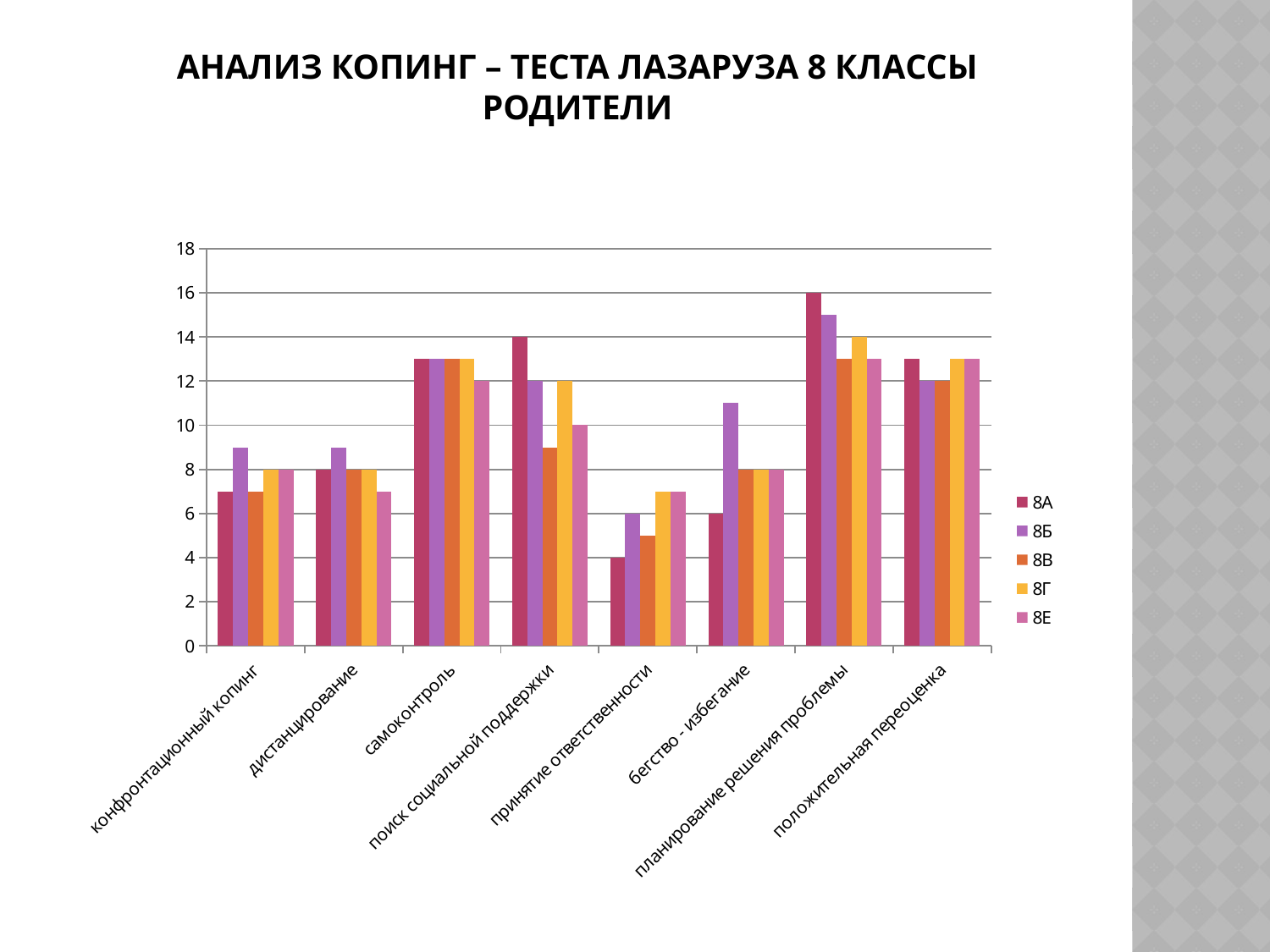
What is the value for 8А in the category 'поиск социальной поддержки'? 14 What is the value for 8А in the category 'принятие ответственности'? 4 In the category 'поиск социальной поддержки', which is larger: the value for 8А or the value for 8В? 8А Is the value for 8Б in 'бегство - избегание' greater or less than 10? greater What is the difference between the 8А value for 'планирование решения проблемы' and the 8А value for 'принятие ответственности'? 12 What kind of chart is shown on the slide? bar chart Which category has the highest value for 8А? планирование решения проблемы What is the value for 8Е in the category 'поиск социальной поддержки'? 10 How many categories are shown on the x axis? 8 How many series does the legend list? 5 What is the value for 8А in the category 'планирование решения проблемы'? 16 Which category has the lowest value for 8А? принятие ответственности